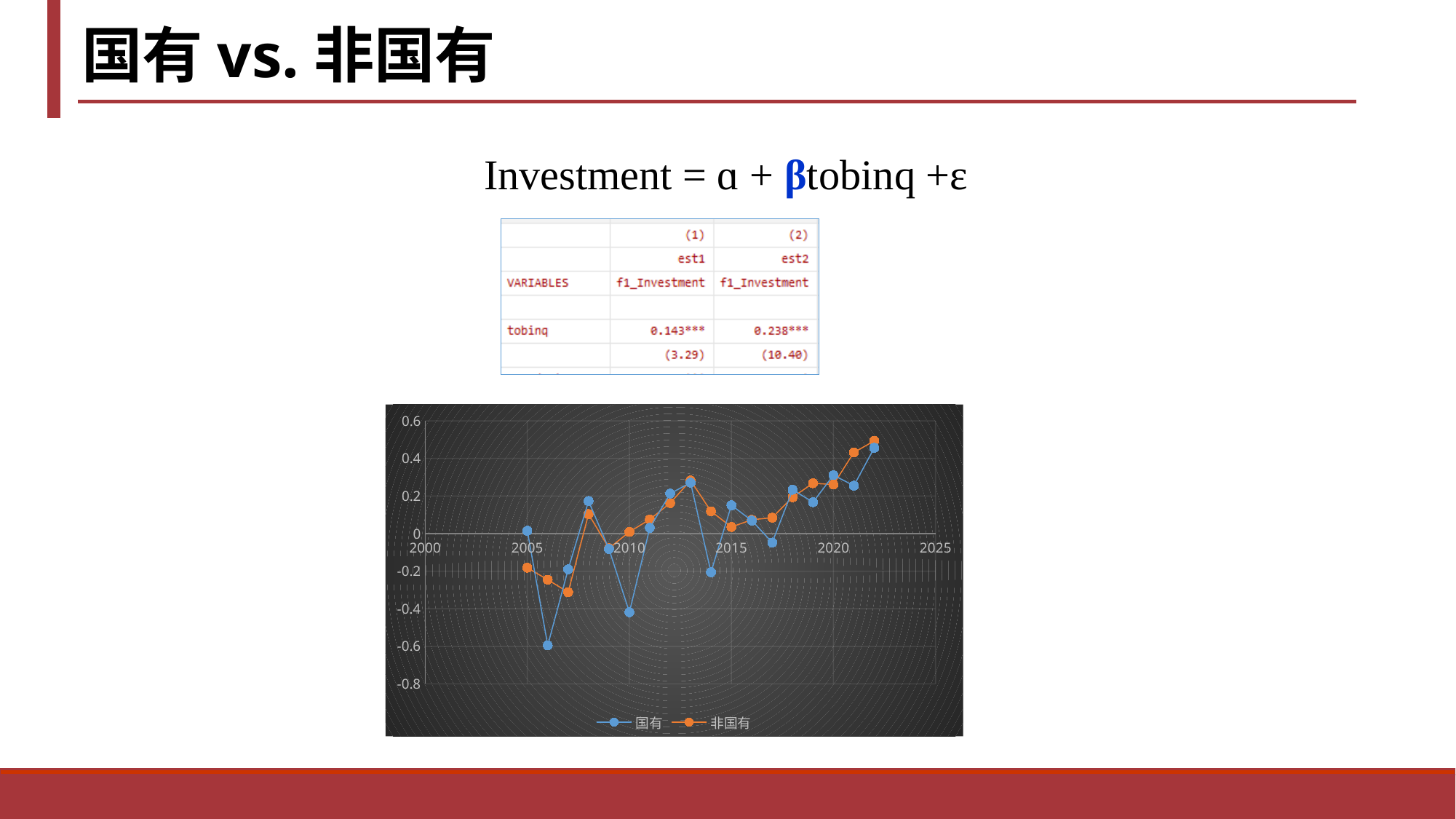
In which year does the 非国有 series reach its lowest value? 2007 What are the two series named in the chart's legend? 国有 and 非国有 In which year does the 国有 series reach its highest value? 2022 In 2006, which series has the higher value, 国有 or 非国有? 非国有 What kind of chart is shown on the slide? line chart How many series does the chart's legend list? 2 Is the value for 国有 in 2010 greater or less than -0.2? less In which year does the 国有 series reach its lowest value? 2006 Is the value for 非国有 in 2022 greater or less than 0.4? greater In which year does the 非国有 series reach its highest value? 2022 Overall, does the 非国有 series rise or fall from 2005 to 2022? rise Is the value for 国有 in 2006 greater or less than -0.4? less